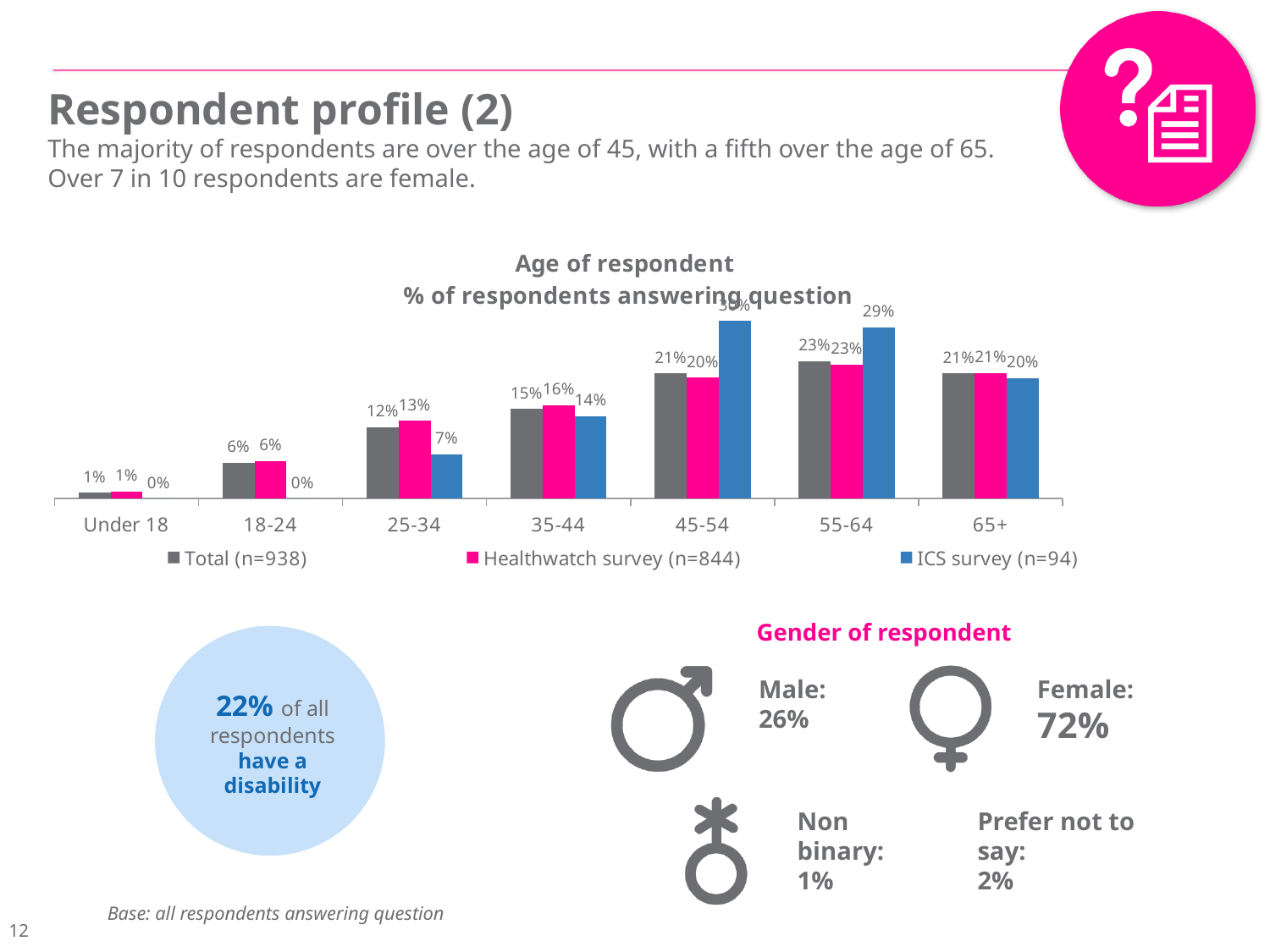
What is the ICS survey (n=94) value for the 25-34 age group? 7% What type of chart is used to show the age of respondents? bar chart Which age group has the highest Total (n=938) value? 55-64 How many series does the legend of the age chart list? 3 What is the difference between the ICS survey (n=94) value and the Total (n=938) value for the 55-64 age group? 6% Which age group has the highest ICS survey (n=94) value? 45-54 Which series in the age chart is shown in pink? Healthwatch survey (n=844) For the 25-34 age group, which is larger: the Healthwatch survey (n=844) value or the ICS survey (n=94) value? Healthwatch survey (n=844) What is the ICS survey (n=94) value for the 18-24 age group? 0% How many age categories are shown on the x axis of the age chart? 7 What is the Healthwatch survey (n=844) value for the 35-44 age group? 16% What is the Total (n=938) value for the 55-64 age group? 23%